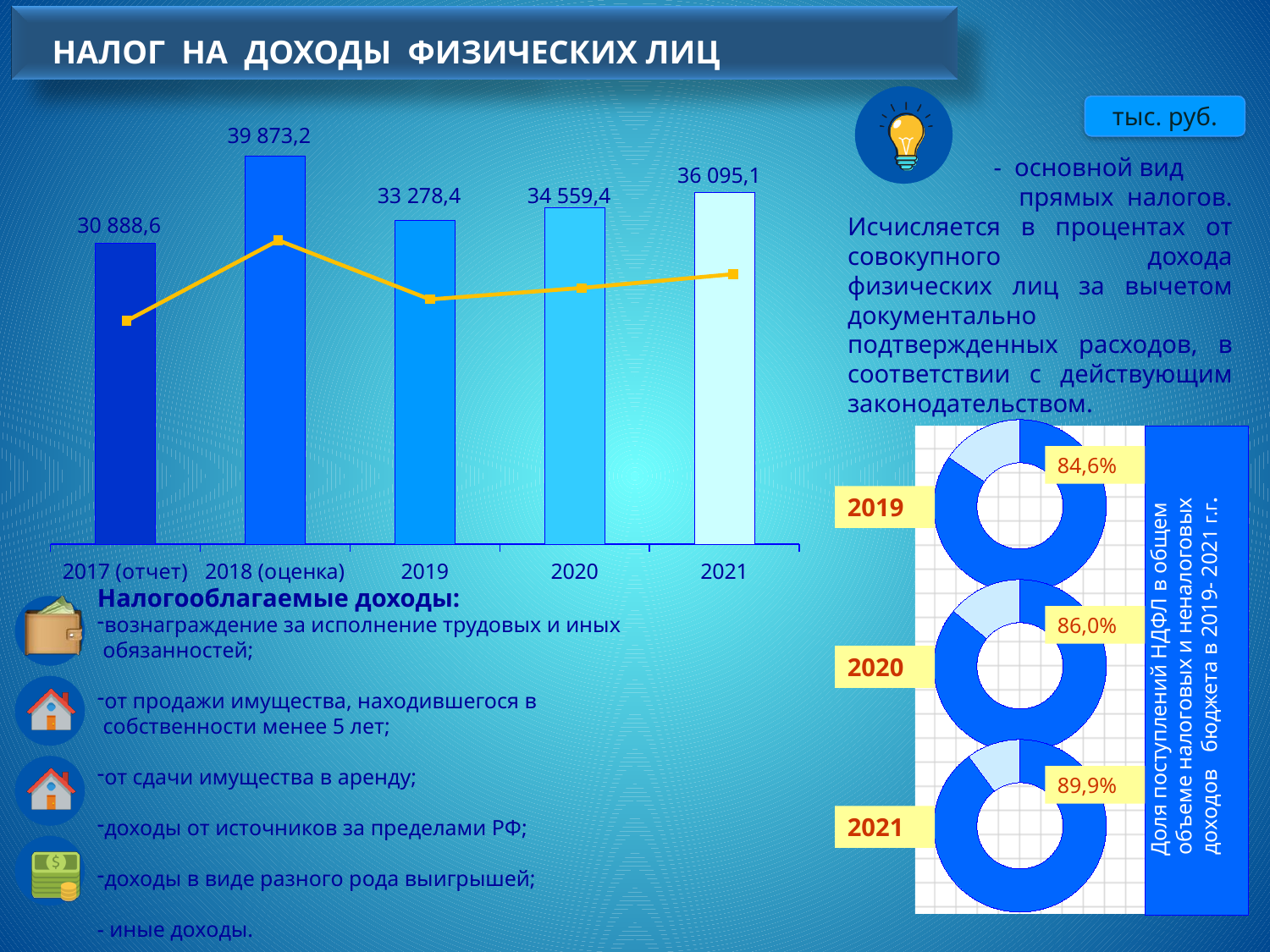
In the bar chart on the left, what is the value for 2018 (оценка)? 39 873,2 In the donut charts on the right, what is the share of НДФЛ for 2020? 86,0% In the bar chart on the left, what is the value for 2021? 36 095,1 In the bar chart on the left, which is larger: the value for 2019 or the value for 2020? 2020 In the donut charts on the right, what is the difference between the shares for 2021 and 2019? 5,3% In the bar chart on the left, which year has the highest value? 2018 (оценка) In the bar chart on the left, what is the difference between the values for 2018 (оценка) and 2017 (отчет)? 8 984,6 In the bar chart on the left, which year has the lowest value? 2017 (отчет) In the bar chart on the left, how many years are shown on the x axis? 5 In the bar chart on the left, what unit is indicated for the values? тыс. руб. In the donut charts on the right, which year has the highest share of НДФЛ? 2021 In the bar chart on the left, do the values rise or fall from 2019 to 2021? rise